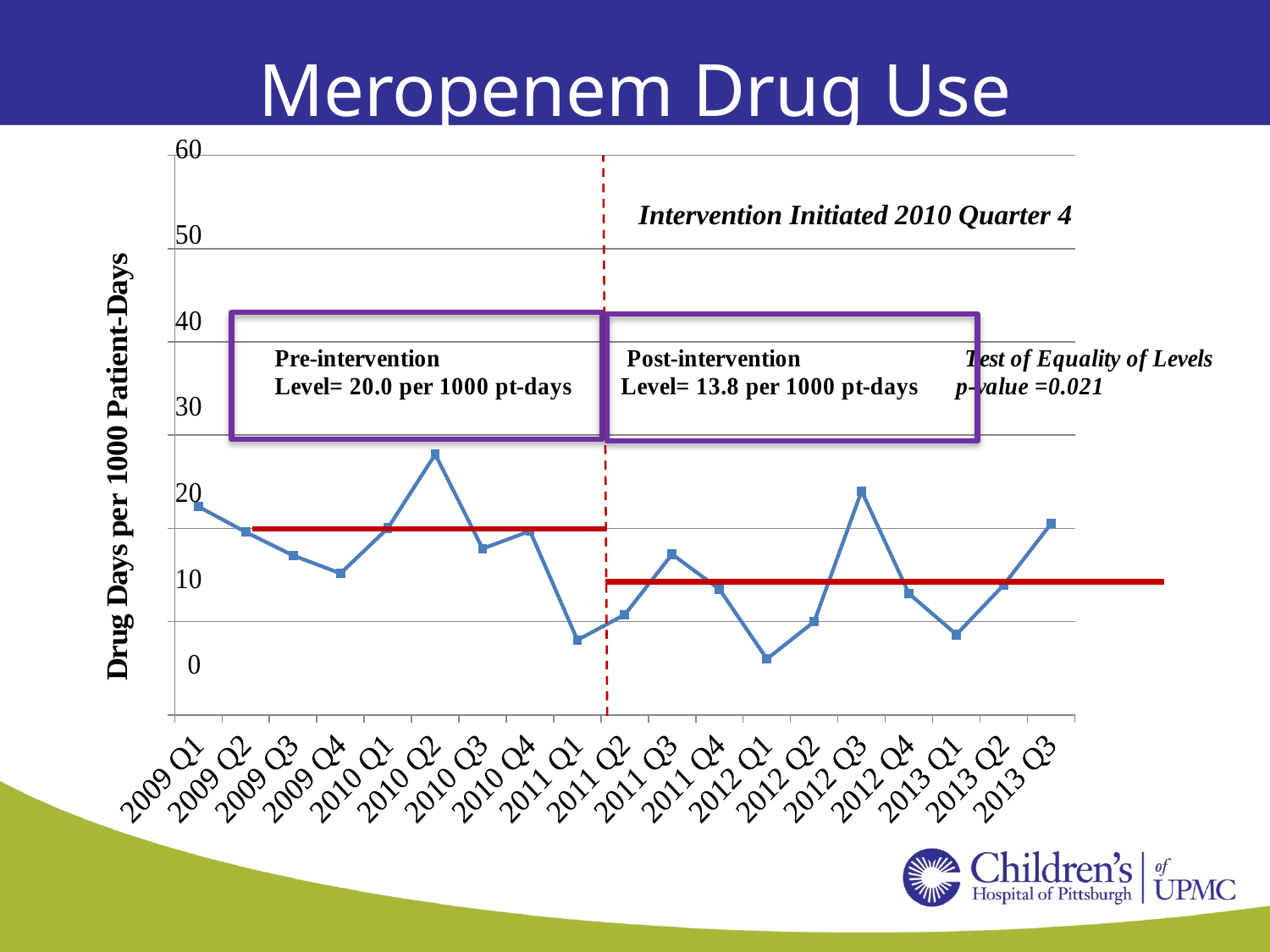
Which quarter has the lowest meropenem drug use? 2012 Q1 What is the title of the chart? Meropenem Drug Use How many quarters are plotted along the x axis? 19 What is the label on the vertical axis? Drug Days per 1000 Patient-Days Is the value for 2010 Q2 greater or less than 20? greater What kind of chart is shown on the slide? line chart What is the post-intervention level stated on the chart? 13.8 per 1000 pt-days What is the pre-intervention level stated on the chart? 20.0 per 1000 pt-days Which quarter has the highest meropenem drug use? 2010 Q2 In which quarter was the intervention initiated? 2010 Quarter 4 What p-value is given for the test of equality of levels? 0.021 By how much did the level fall from pre-intervention to post-intervention? 6.2 per 1000 pt-days